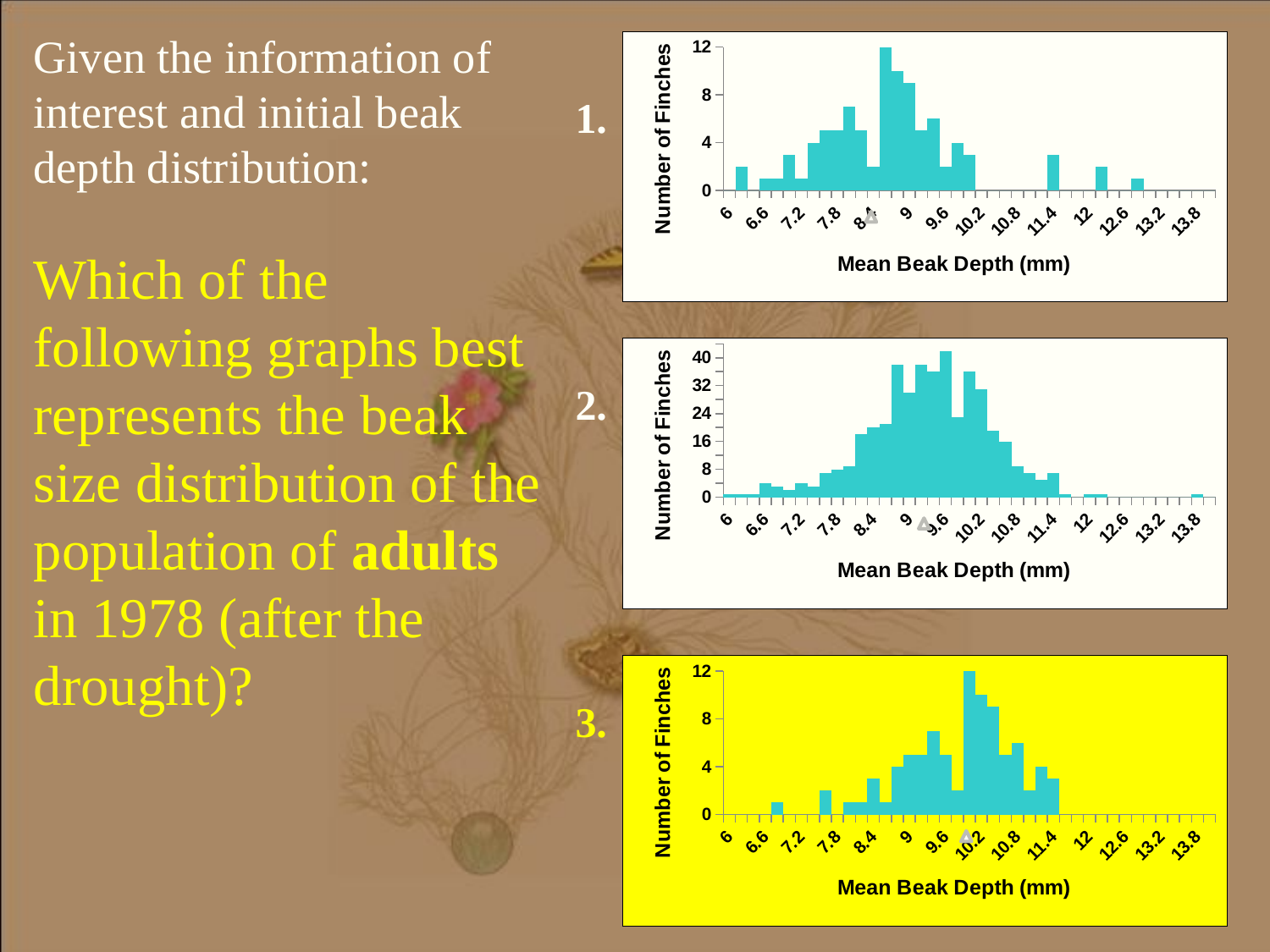
In chart 1 (the top chart), which bar is taller: the one at 9 mm or the one at 7.8 mm? 9 mm How many charts are shown on the slide? 3 What is the highest tick value on the y-axis of chart 2 (the middle chart)? 40 In chart 1 (the top chart), is the value for 11.4 mm greater or less than 4? less What is the y-axis title of chart 2 (the middle chart)? Number of Finches In chart 2 (the middle chart), is the value of the tallest bar greater or less than 32? greater What kind of chart is chart 1 (the top chart)? bar chart